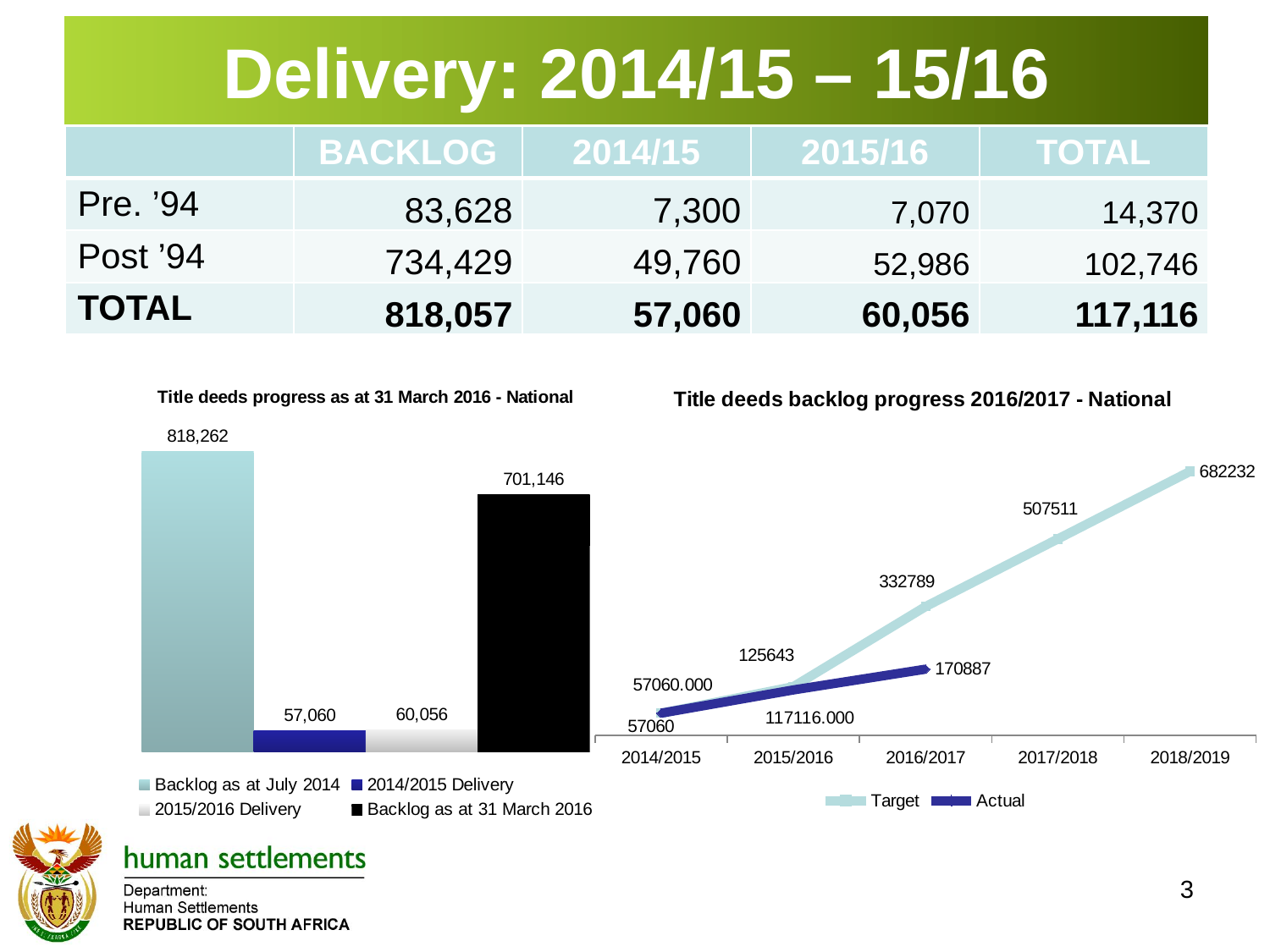
In the 'Title deeds backlog progress 2016/2017 - National' chart, what is the Actual value for 2016/2017? 170887 In the 'Title deeds progress as at 31 March 2016 - National' chart, what is the value of the 'Backlog as at July 2014' bar? 818,262 In the 'Title deeds backlog progress 2016/2017 - National' chart, what is the Target value for 2016/2017? 332789 What type of chart is 'Title deeds progress as at 31 March 2016 - National'? Bar chart In the 'Title deeds progress as at 31 March 2016 - National' chart, how many bars are plotted? 4 In the 'Title deeds backlog progress 2016/2017 - National' chart, how many series does the legend list? 2 In the 'Title deeds backlog progress 2016/2017 - National' chart, does the Target line rise or fall from 2014/2015 to 2018/2019? Rises In the 'Title deeds backlog progress 2016/2017 - National' chart, which is larger for 2016/2017: Target or Actual? Target In the 'Title deeds backlog progress 2016/2017 - National' chart, what is the Target value for 2018/2019? 682232 In the 'Title deeds progress as at 31 March 2016 - National' chart, what is the difference between the 2015/2016 Delivery and the 2014/2015 Delivery? 2,996 In the 'Title deeds progress as at 31 March 2016 - National' chart, which bar is the lowest? 2014/2015 Delivery In the 'Title deeds progress as at 31 March 2016 - National' chart, what is the value of the 'Backlog as at 31 March 2016' bar? 701,146